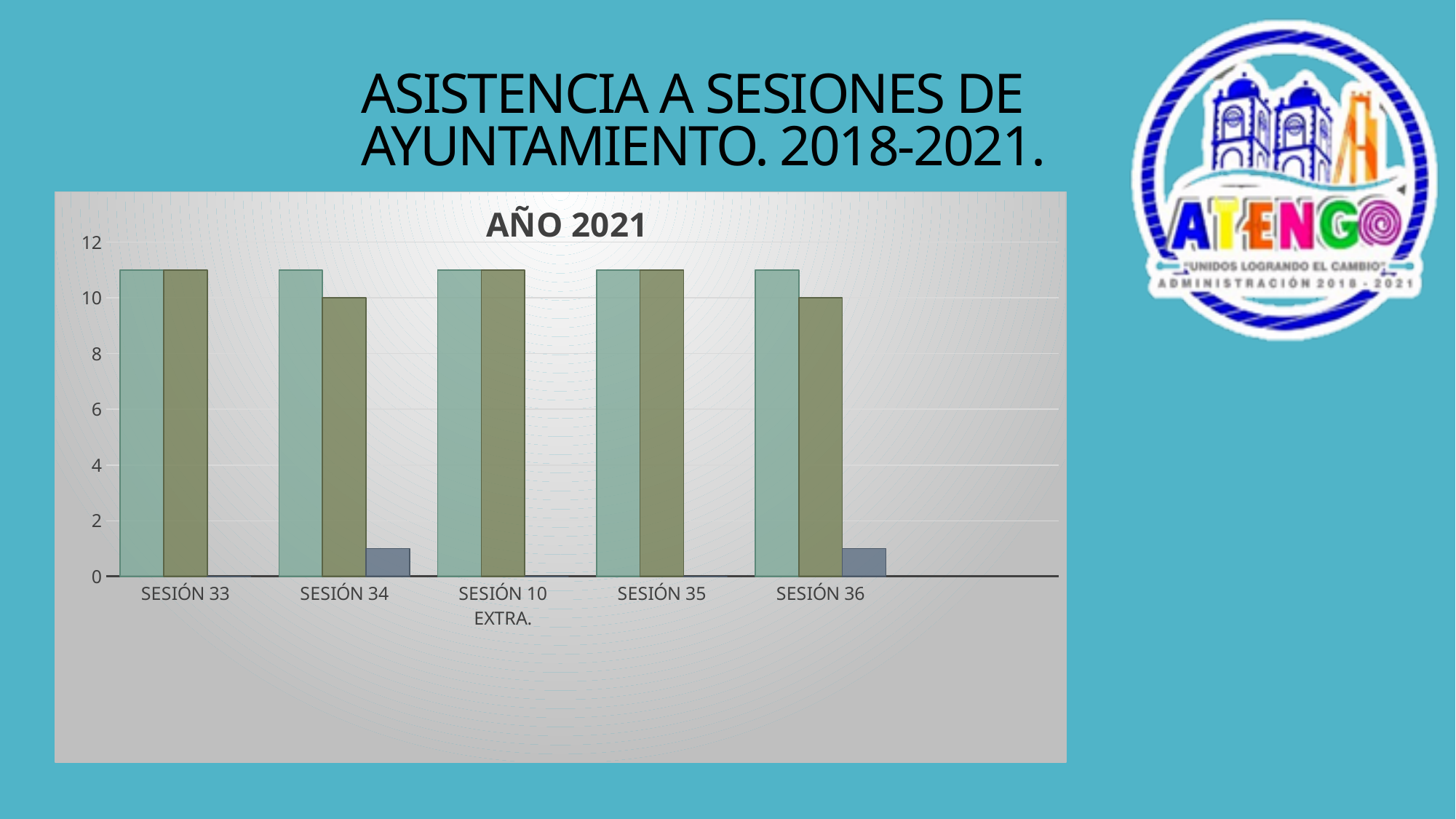
Is the value of the first (light green) bar for SESIÓN 35 greater or less than 12? less What kind of chart is shown on the slide? bar chart Which is larger: the second (olive) bar for SESIÓN 33 or the second (olive) bar for SESIÓN 36? SESIÓN 33 For SESIÓN 34, which is larger: the first (light green) bar or the second (olive) bar? the first (light green) bar What is the value of the second (olive) bar for SESIÓN 34? 10 How many sessions (categories) are shown on the x axis of the chart? 5 Which session has the lowest value for the second (olive) bar, SESIÓN 35 or SESIÓN 36? SESIÓN 36 Is the value of the third (grey-blue) bar for SESIÓN 34 greater or less than 2? less How many bars are plotted for each session in the chart? 3 What is the title of the chart? AÑO 2021 Is the value of the first (light green) bar for SESIÓN 33 greater or less than 10? greater What is the value of the second (olive) bar for SESIÓN 36? 10